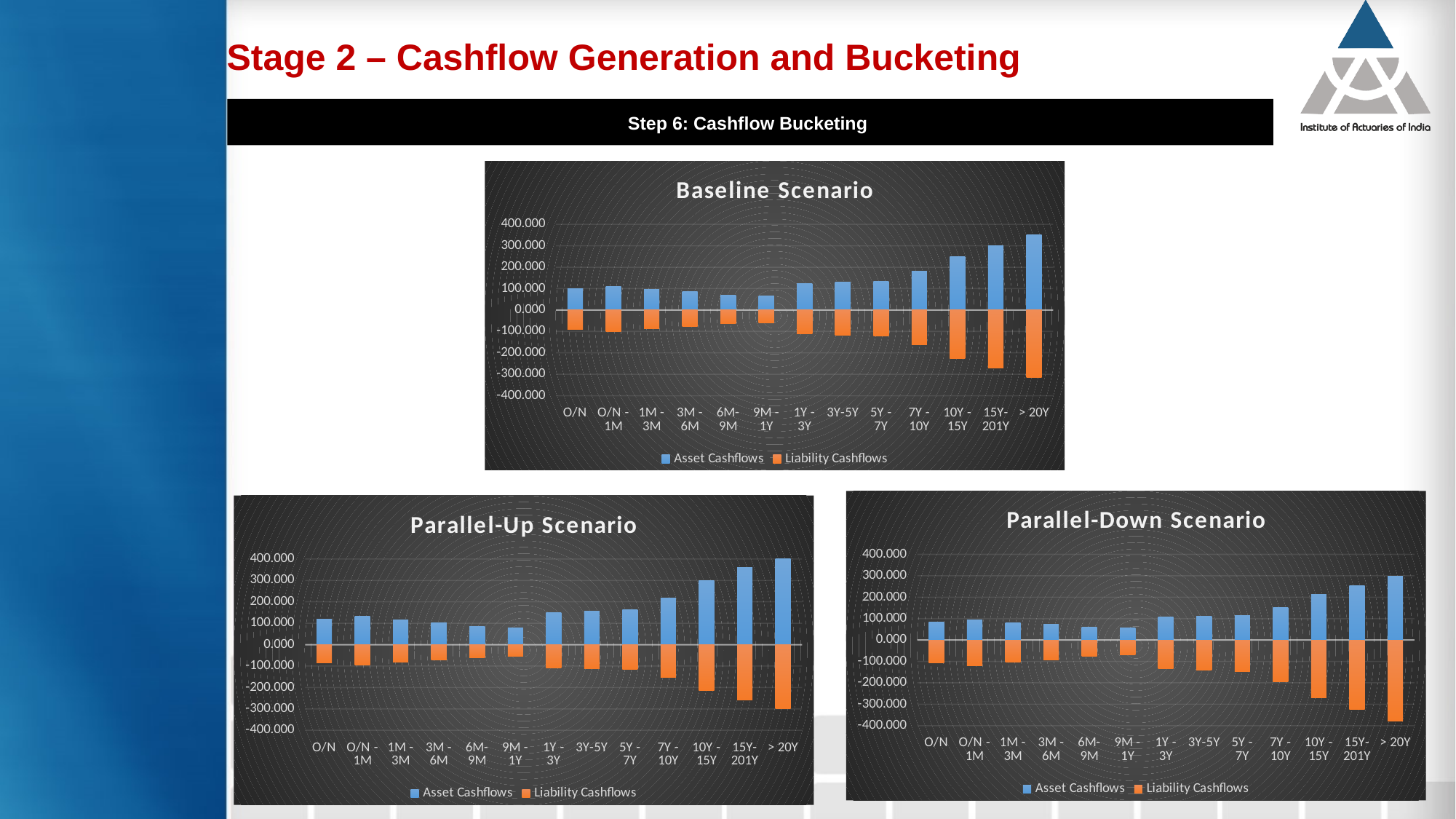
In the Baseline Scenario chart, which bucket has the highest Asset Cashflows value? > 20Y In the Baseline Scenario chart, is the Asset Cashflows value for > 20Y greater or less than 300.000? greater In the Parallel-Down Scenario chart, is the Asset Cashflows value for 7Y - 10Y greater or less than 100.000? greater In the Baseline Scenario chart, is the Liability Cashflows value for 15Y-201Y greater or less than -200.000? less In the Parallel-Up Scenario chart, do the Asset Cashflows values generally rise or fall from the 1Y - 3Y bucket to the > 20Y bucket? rise In the Baseline Scenario chart, which is larger: the Asset Cashflows value for > 20Y or for O/N? > 20Y What are the two legend entries in the Parallel-Down Scenario chart? Asset Cashflows, Liability Cashflows How many time buckets are shown on the x axis of the Parallel-Down Scenario chart? 13 What kind of chart is the Baseline Scenario chart? bar chart In the Parallel-Up Scenario chart, which bucket has the lowest Liability Cashflows value (most negative)? > 20Y How many series does the legend of the Parallel-Up Scenario chart list? 2